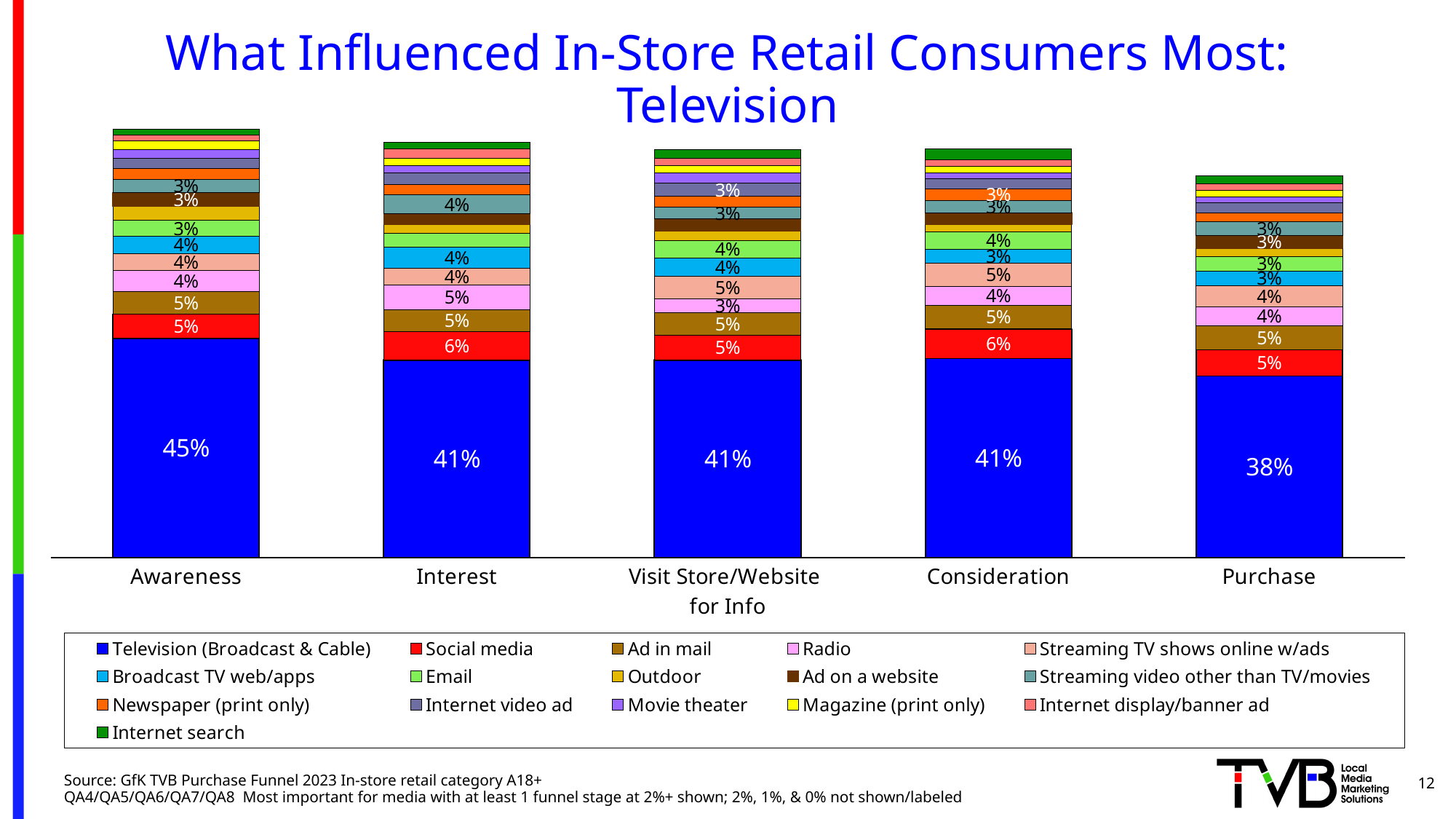
How many funnel stages (categories) are shown along the x axis? 5 What is the difference between the Television (Broadcast & Cable) values at Awareness and Purchase? 7 percentage points What kind of chart is shown on the slide? Stacked bar chart What is the value for Radio at the Interest stage? 5% At which stage is the Television (Broadcast & Cable) value lowest? Purchase How many series does the legend list? 16 At which stage is the Television (Broadcast & Cable) value highest? Awareness What is the value for Television (Broadcast & Cable) at the Purchase stage? 38% What is the value for Social media at the Interest stage? 6% What is the title of the chart on the slide? What Influenced In-Store Retail Consumers Most: Television Which is larger: the Television (Broadcast & Cable) value at Awareness or at Interest? Awareness What is the value for Television (Broadcast & Cable) at the Awareness stage? 45%